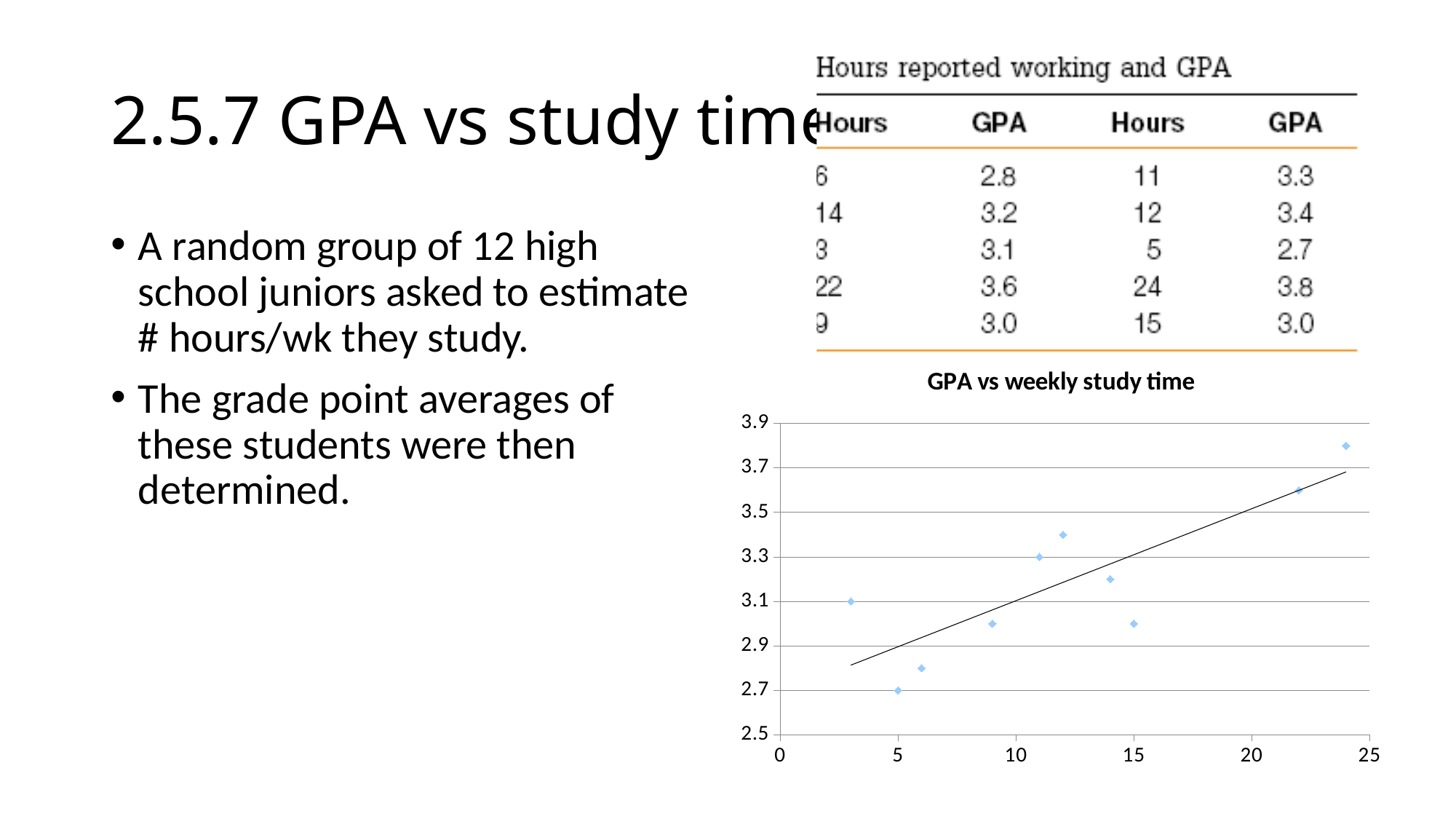
How many data points are plotted in the GPA vs weekly study time chart? 10 In the GPA vs weekly study time chart, do GPA values generally rise or fall as weekly study hours increase? rise In the GPA vs weekly study time chart, is the GPA for the point at 22 hours greater or less than 3.5? greater In the GPA vs weekly study time chart, which point has the higher GPA: the one at 12 hours or the one at 15 hours? 12 hours What is the title of the chart on the slide? GPA vs weekly study time In the GPA vs weekly study time chart, is the GPA for the point at 6 hours greater or less than 2.9? less What is the highest value shown on the vertical axis of the GPA vs weekly study time chart? 3.9 In the GPA vs weekly study time chart, what is the GPA of the point at 5 hours of study? 2.7 In the GPA vs weekly study time chart, is the GPA for the point at 24 hours greater or less than 3.7? greater What kind of chart is shown on the slide? scatter chart In the GPA vs weekly study time chart, at how many study hours is the highest GPA plotted? 24 In the GPA vs weekly study time chart, at how many study hours is the lowest GPA plotted? 5